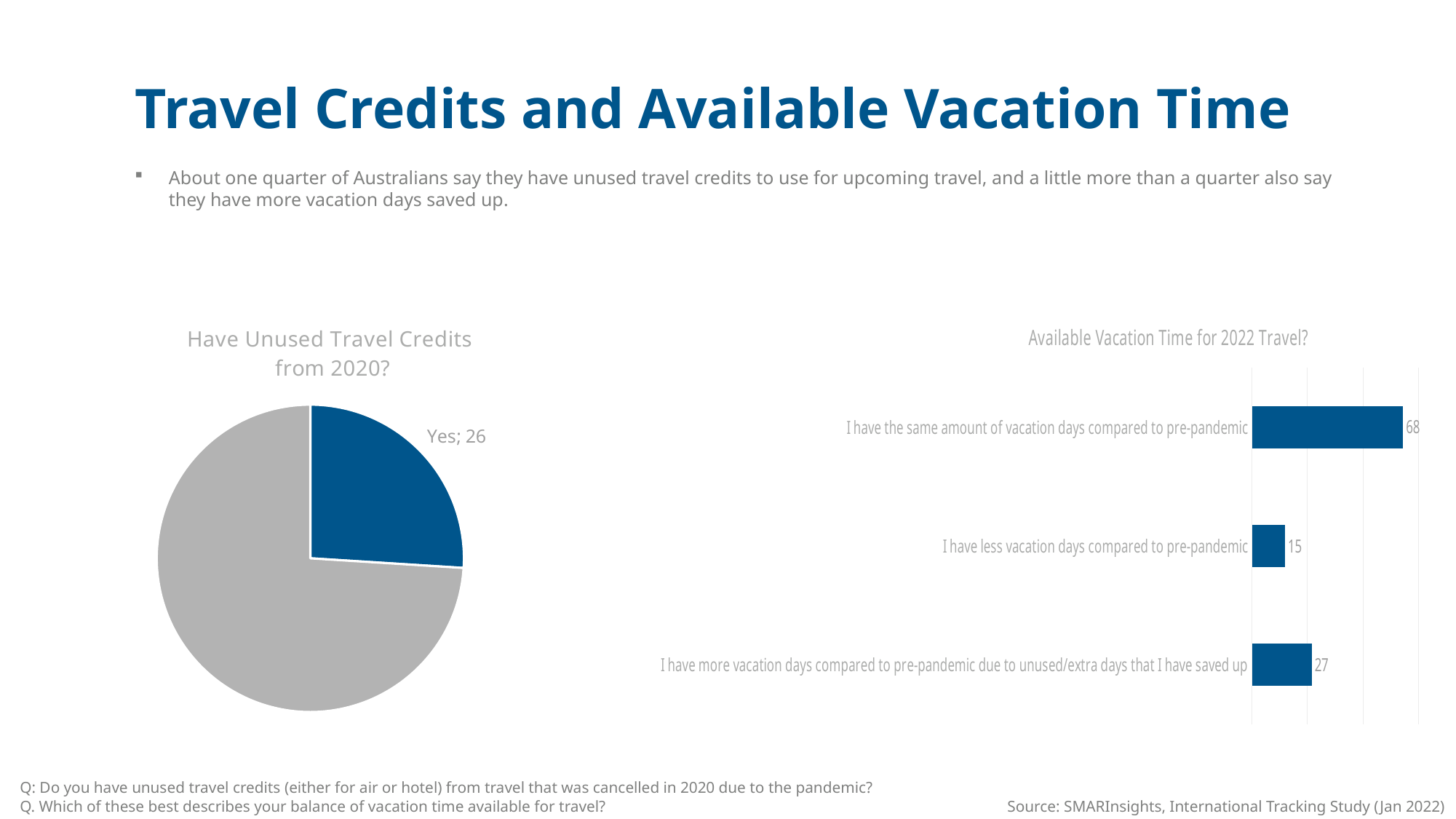
In the 'Available Vacation Time for 2022 Travel?' chart, what is the value for 'I have the same amount of vacation days compared to pre-pandemic'? 68 In the 'Available Vacation Time for 2022 Travel?' chart, which category has the highest value? I have the same amount of vacation days compared to pre-pandemic In the 'Have Unused Travel Credits from 2020?' chart, what value is shown for Yes? 26 What kind of chart is 'Have Unused Travel Credits from 2020?'? pie chart What kind of chart is 'Available Vacation Time for 2022 Travel?'? bar chart In the 'Available Vacation Time for 2022 Travel?' chart, which is larger: the value for 'less vacation days' or the value for 'more vacation days'? more vacation days In the 'Available Vacation Time for 2022 Travel?' chart, what is the difference between the value for 'same amount of vacation days' and the value for 'more vacation days'? 41 In the 'Available Vacation Time for 2022 Travel?' chart, what is the value for 'I have more vacation days compared to pre-pandemic due to unused/extra days that I have saved up'? 27 How many categories are shown in the 'Available Vacation Time for 2022 Travel?' chart? 3 In the 'Available Vacation Time for 2022 Travel?' chart, what is the value for 'I have less vacation days compared to pre-pandemic'? 15 What is the title of the pie chart on the left of the slide? Have Unused Travel Credits from 2020? In the 'Available Vacation Time for 2022 Travel?' chart, which category has the lowest value? I have less vacation days compared to pre-pandemic